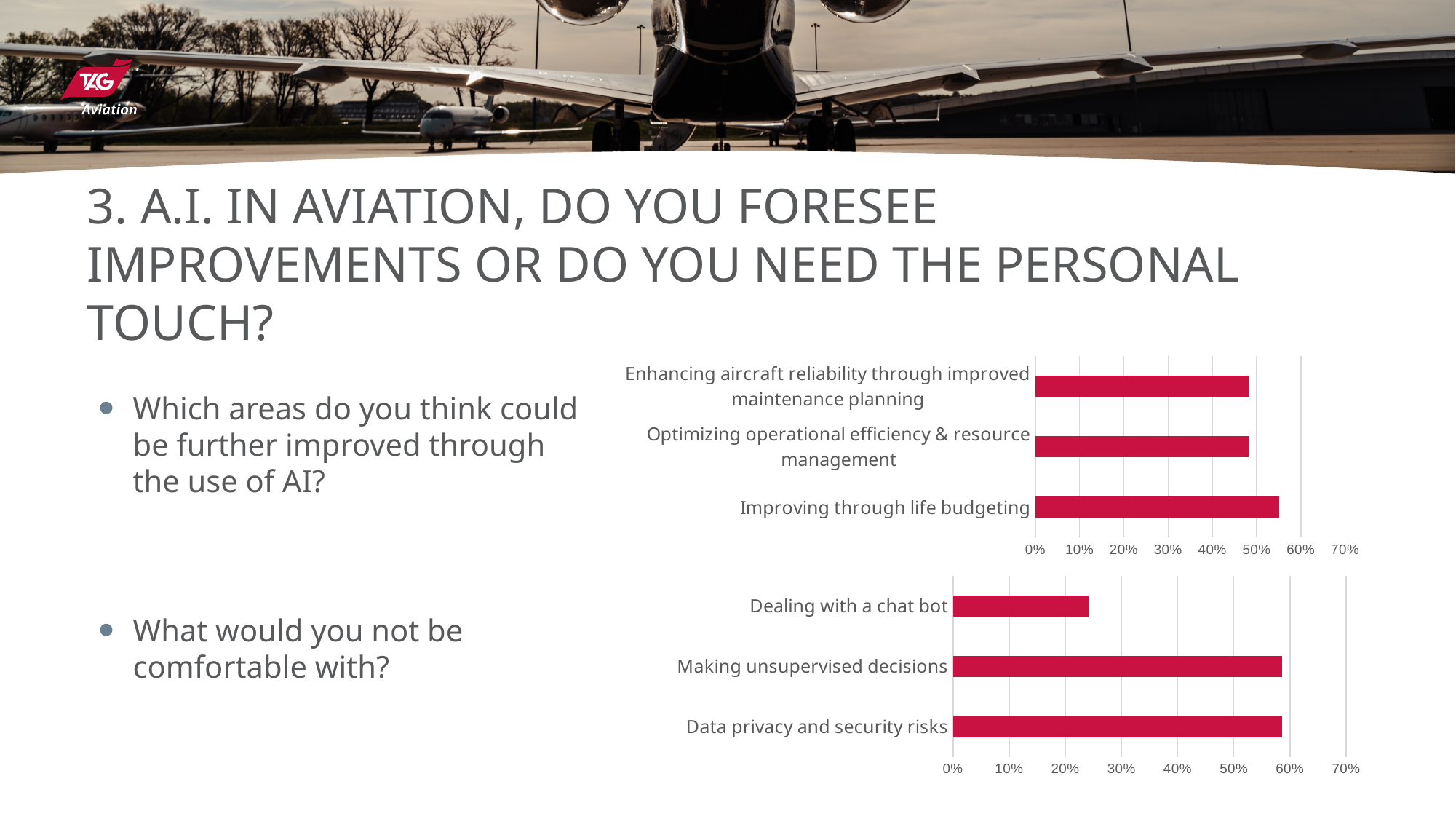
In the lower chart, which is larger: the value for Making unsupervised decisions or the value for Dealing with a chat bot? Making unsupervised decisions In the upper chart, is the value for Optimizing operational efficiency & resource management greater or less than 60%? less What is the highest value shown on the x axis of the lower chart? 70% In the lower chart, is the value for Data privacy and security risks greater or less than 50%? greater In the lower chart, which category has the lowest value? Dealing with a chat bot In the upper chart, which category has the highest value? Improving through life budgeting How many categories does the upper chart (areas that could be improved through AI) show? 3 What kind of chart is the upper chart on the right of the slide? bar chart In the lower chart, is the value for Dealing with a chat bot greater or less than 30%? less How many categories does the lower chart (what respondents would not be comfortable with) show? 3